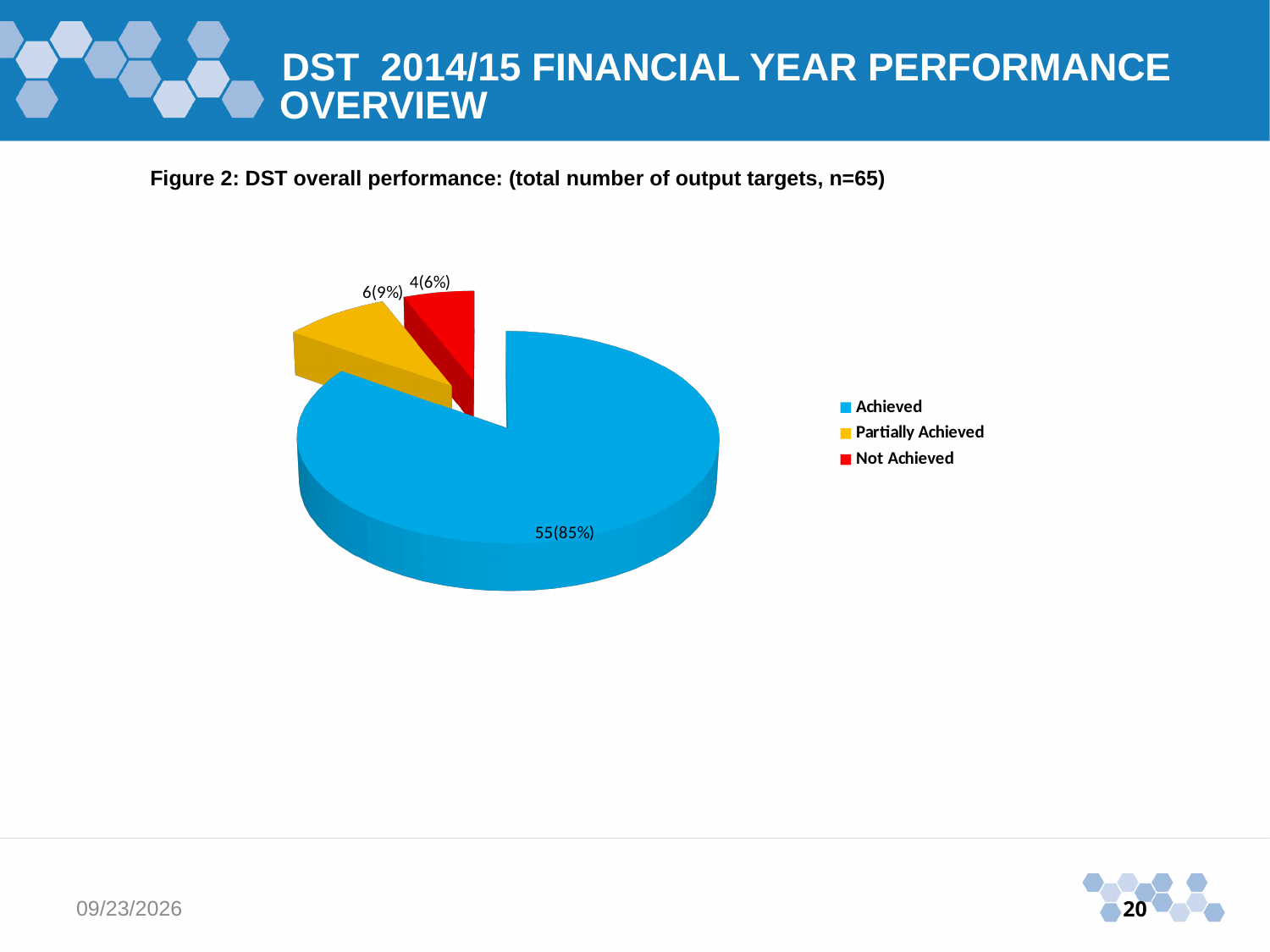
What share of the pie does the Achieved slice represent? 85% What is the data label for the Not Achieved slice? 4(6%) How many slices does the pie chart have? 3 What colour is the Not Achieved slice? red Which category has the smallest slice? Not Achieved Which is larger, the Partially Achieved slice or the Not Achieved slice? Partially Achieved What is the data label for the Achieved slice? 55(85%) How many more output targets were Achieved than Partially Achieved? 49 How many entries does the legend list? 3 Which category has the largest slice? Achieved What is the data label for the Partially Achieved slice? 6(9%) What kind of chart is shown on the slide? pie chart